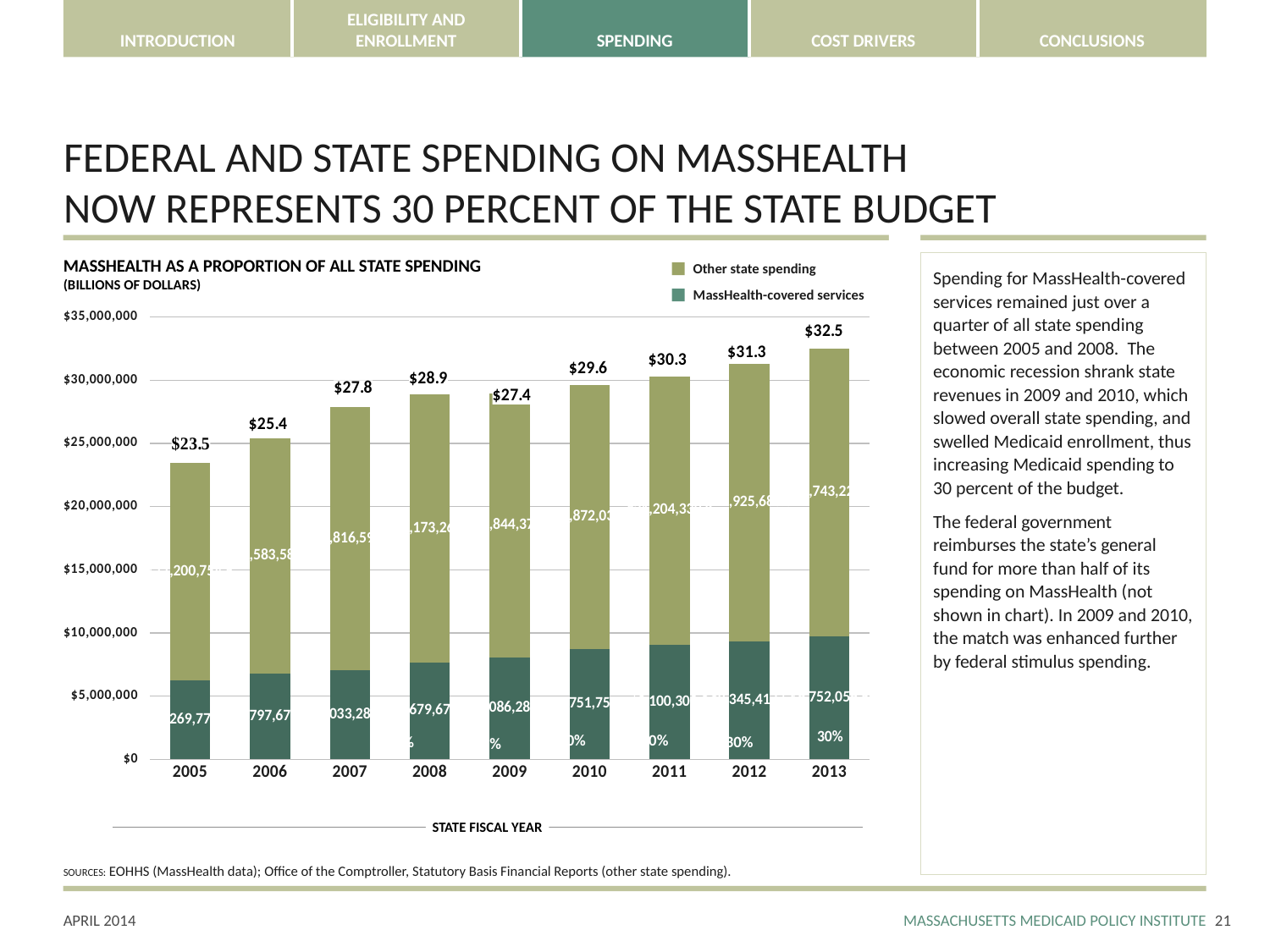
What is the total state spending shown for 2005? $23.5 Which state fiscal year has the highest total state spending? 2013 Which year has a larger total state spending, 2008 or 2009? 2008 Is the value for MassHealth-covered services in 2013 greater or less than $10,000,000? less Which state fiscal year has the lowest total state spending? 2005 What is the total state spending shown for 2013? $32.5 How many state fiscal years are shown on the x axis? 9 How many series does the legend list? 2 What is the difference between the total state spending in 2013 and in 2005? $9.0 What kind of chart is shown on the slide? Stacked bar chart What are the two series listed in the legend? Other state spending; MassHealth-covered services What is the total state spending shown for 2009? $27.4